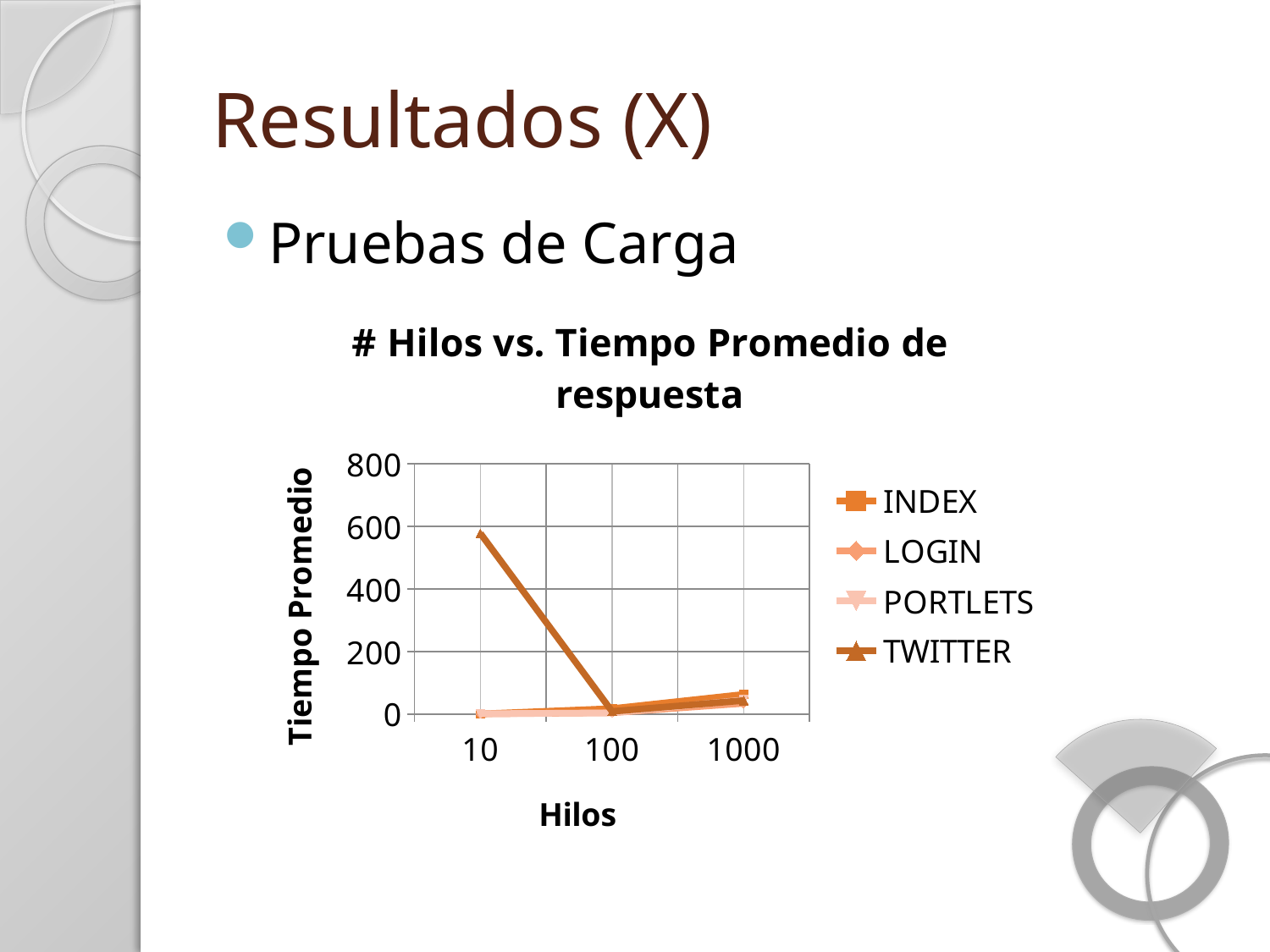
How many series does the legend list? 4 Does the TWITTER series rise or fall from 10 Hilos to 100 Hilos? fall What is the title of the chart? # Hilos vs. Tiempo Promedio de respuesta Which series has the highest Tiempo Promedio at 10 Hilos? TWITTER Is the value for TWITTER at 10 Hilos greater or less than 400? greater Is the value for INDEX at 1000 Hilos greater or less than 200? less Does the INDEX series rise or fall from 100 Hilos to 1000 Hilos? rise Which is larger at 10 Hilos, the value for TWITTER or the value for INDEX? TWITTER Is the value for TWITTER at 10 Hilos greater or less than 600? less What is the label of the vertical axis? Tiempo Promedio What kind of chart is shown on the slide? line chart How many values of Hilos are shown on the x axis? 3